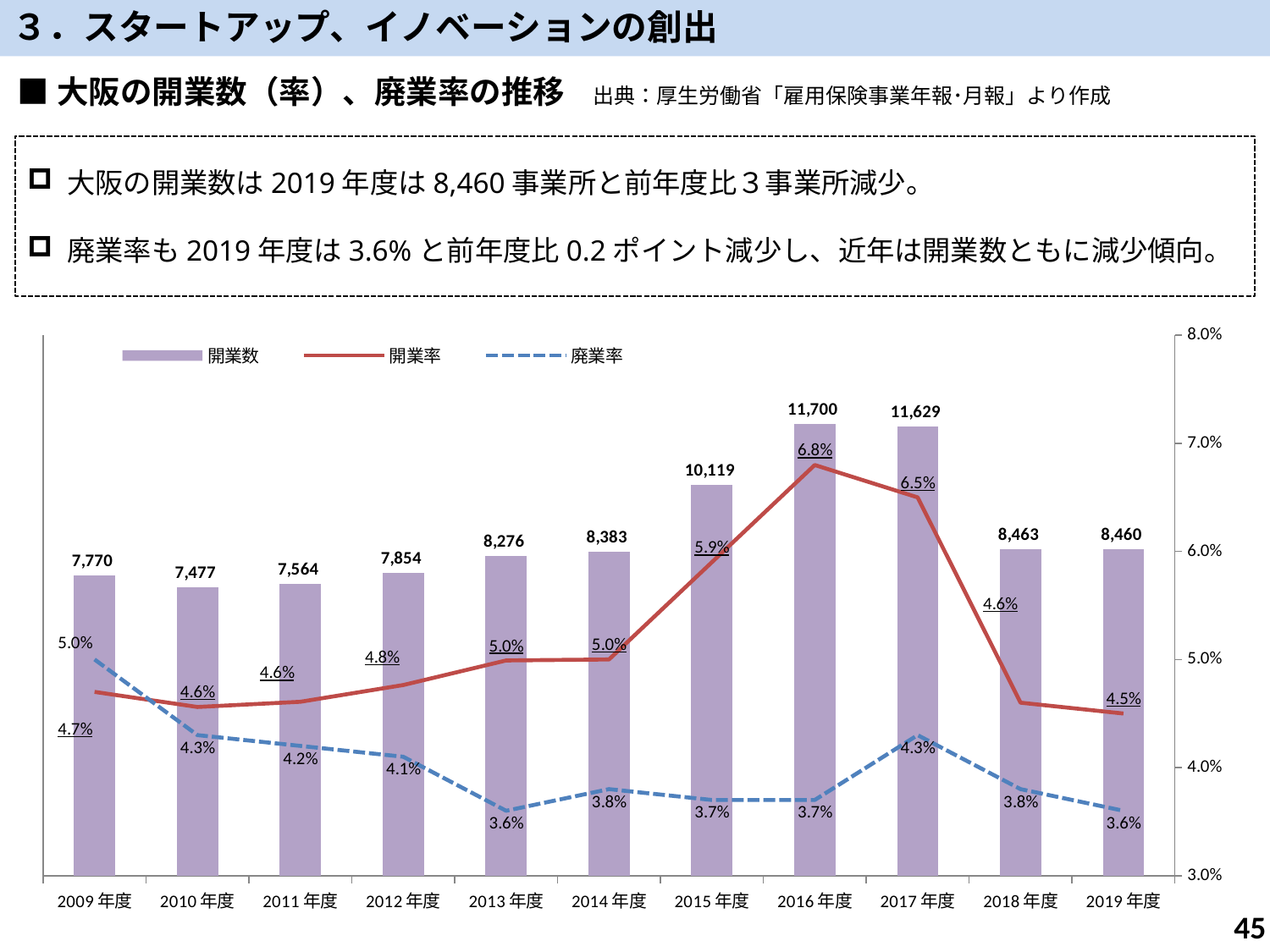
開業数はどの種類のグラフで表されていますか？ 棒グラフ 開業数が最も多い年度はどれですか？ 2016年度 2016年度の開業率は何％ですか？ 6.8% 2013年度の廃業率は何％ですか？ 3.6% 2016年度から2019年度にかけて、開業率は上昇していますか、下降していますか？ 下降 2017年度の開業率は6.0%より高いですか、低いですか？ 高い 開業数が最も少ない年度はどれですか？ 2010年度 凡例にはいくつの系列が示されていますか？ 3 2009年度の廃業率と開業率では、どちらが高いですか？ 廃業率 2019年度の開業数はいくつですか？ 8,460 グラフには何年度分のデータが表示されていますか？ 11 2016年度と2017年度の開業数の差はいくつですか？ 71